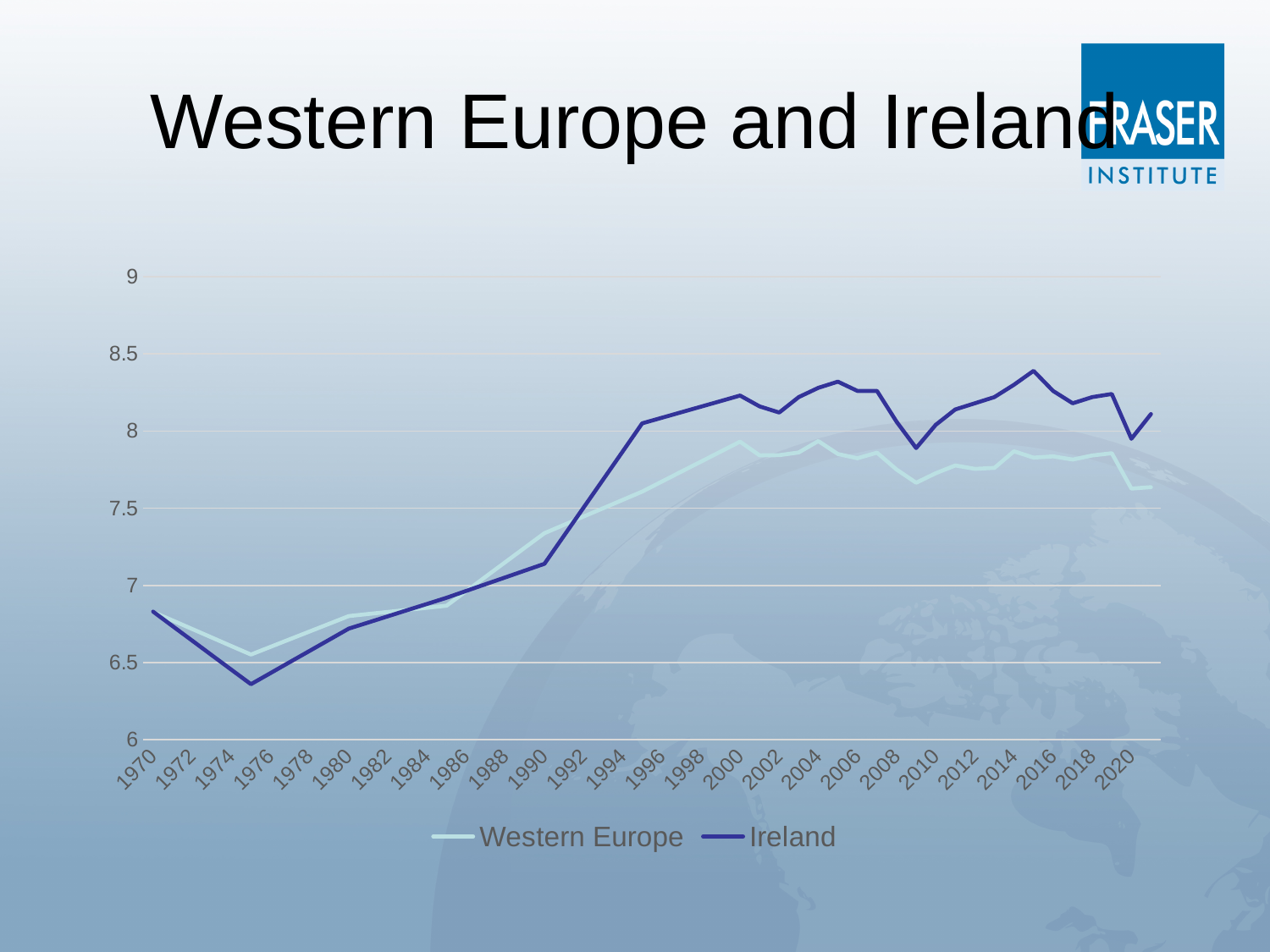
In 2016, which series has the higher value, Western Europe or Ireland? Ireland What is the title of the slide containing the chart? Western Europe and Ireland What kind of chart is shown on the slide? line chart What are the two series named in the legend? Western Europe and Ireland Is the value for Western Europe in 2020 greater or less than 8? less How many series does the legend list? 2 Is the value for Western Europe in 2000 greater or less than 7.5? greater Is the value for Ireland in 1976 greater or less than 6.5? less Does the Ireland line rise or fall between 1976 and 1996? rise In 1976, which series has the higher value, Western Europe or Ireland? Western Europe Which series reaches the highest value anywhere on the chart? Ireland